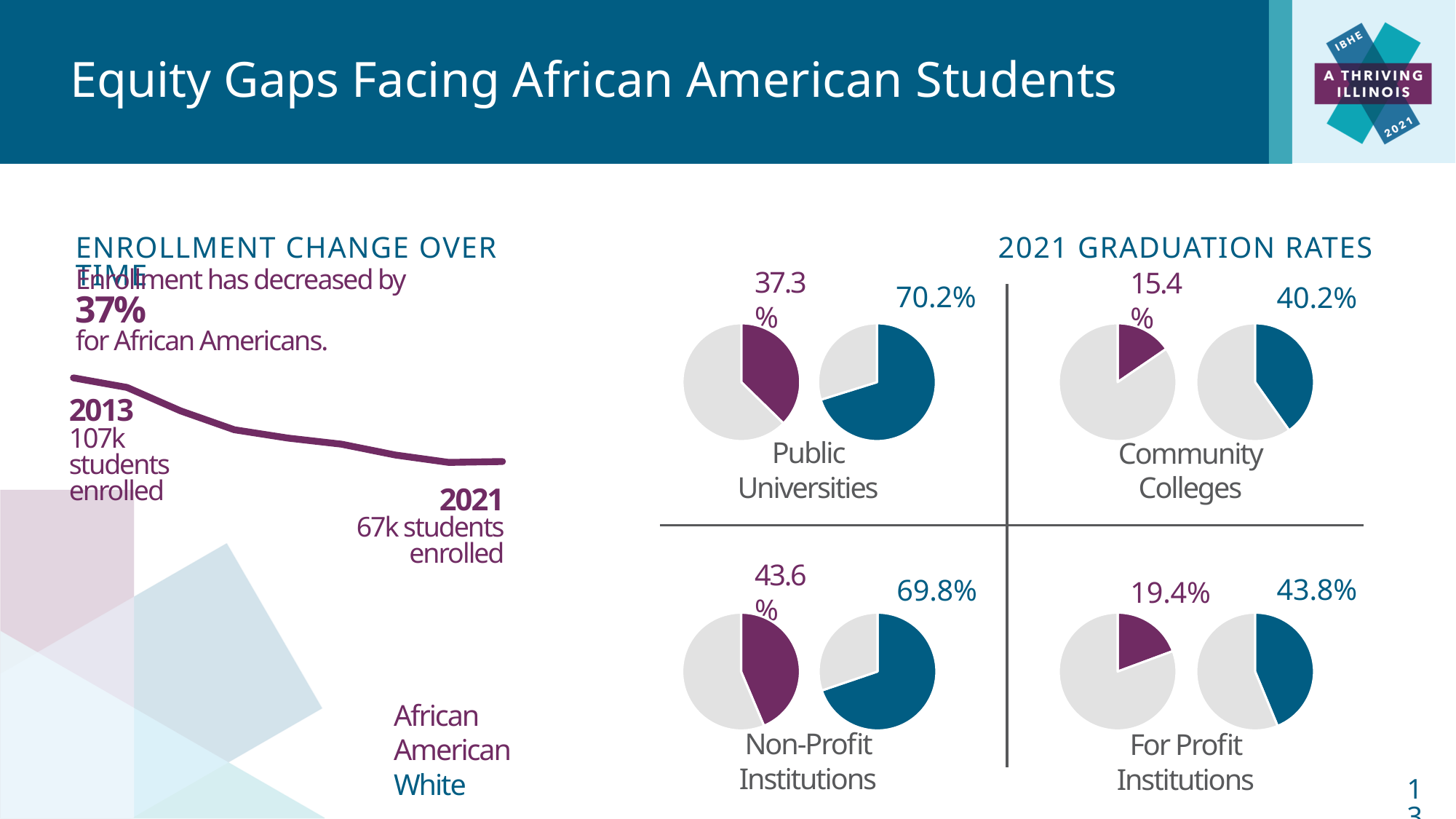
In the 2021 Graduation Rates charts, what is the difference between the White and African American graduation rates at Public Universities? 32.9 percentage points In the 2021 Graduation Rates charts, what is the graduation rate for White students at Community Colleges? 40.2% In the 2021 Graduation Rates charts, which institution type has the lowest graduation rate for African American students? Community Colleges In the 2021 Graduation Rates charts, which institution type has the highest graduation rate for African American students? Non-Profit Institutions In the 2021 Graduation Rates charts, what is the difference between the White and African American graduation rates at Community Colleges? 24.8 percentage points In the 2021 Graduation Rates charts, what is the graduation rate for African American students at Public Universities? 37.3% In the 2021 Graduation Rates charts, what is the graduation rate for African American students at Non-Profit Institutions? 43.6% What kind of chart is used for Enrollment Change Over Time? Line chart In the 2021 Graduation Rates charts, is the African American graduation rate higher at For Profit Institutions or at Community Colleges? For Profit Institutions In the 2021 Graduation Rates charts, what is the graduation rate for White students at For Profit Institutions? 43.8% In the Enrollment Change Over Time chart, how many African American students were enrolled in 2013? 107k In the Enrollment Change Over Time chart, does African American enrollment rise or fall from 2013 to 2021? Fall